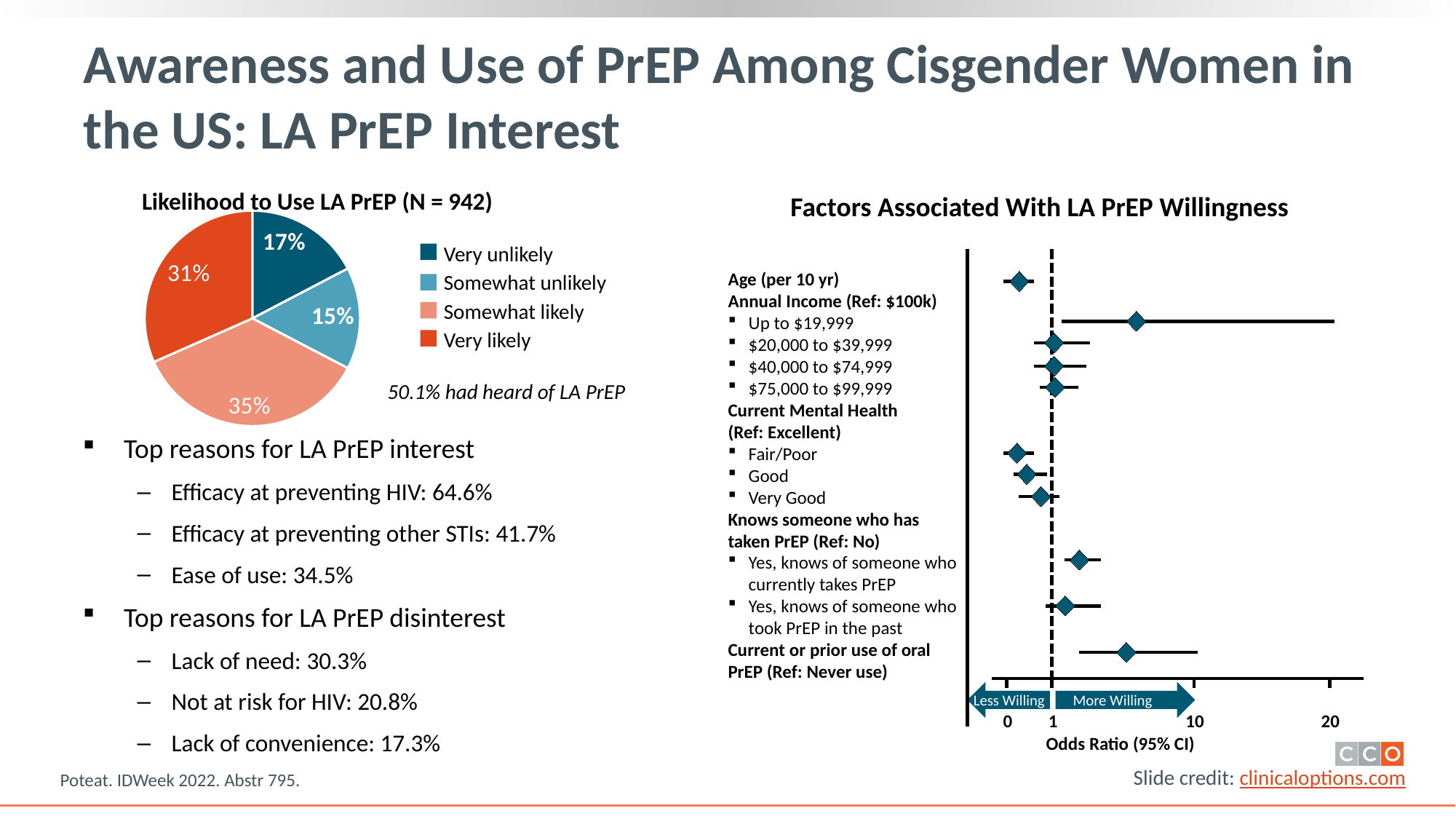
In the chart 'Factors Associated With LA PrEP Willingness', is the odds ratio for Fair/Poor current mental health greater or less than 1? less In the pie chart 'Likelihood to Use LA PrEP (N = 942)', what percentage of respondents were very unlikely to use LA PrEP? 17% In the pie chart 'Likelihood to Use LA PrEP (N = 942)', which is larger: the 'Very unlikely' slice or the 'Somewhat unlikely' slice? Very unlikely What type of chart is 'Likelihood to Use LA PrEP (N = 942)'? Pie chart In the pie chart 'Likelihood to Use LA PrEP (N = 942)', what percentage of respondents were somewhat likely to use LA PrEP? 35% In the pie chart 'Likelihood to Use LA PrEP (N = 942)', what percentage of respondents were very likely to use LA PrEP? 31% In the pie chart 'Likelihood to Use LA PrEP (N = 942)', what is the difference in percentage points between the 'Somewhat likely' and 'Very likely' slices? 4 In the pie chart 'Likelihood to Use LA PrEP (N = 942)', which category has the largest share? Somewhat likely How many categories does the legend of the pie chart 'Likelihood to Use LA PrEP (N = 942)' list? 4 In the chart 'Factors Associated With LA PrEP Willingness', is the odds ratio for annual income up to $19,999 greater or less than 1? greater In the pie chart 'Likelihood to Use LA PrEP (N = 942)', which category has the smallest share? Somewhat unlikely In the chart 'Factors Associated With LA PrEP Willingness', what is the label of the x-axis? Odds Ratio (95% CI)